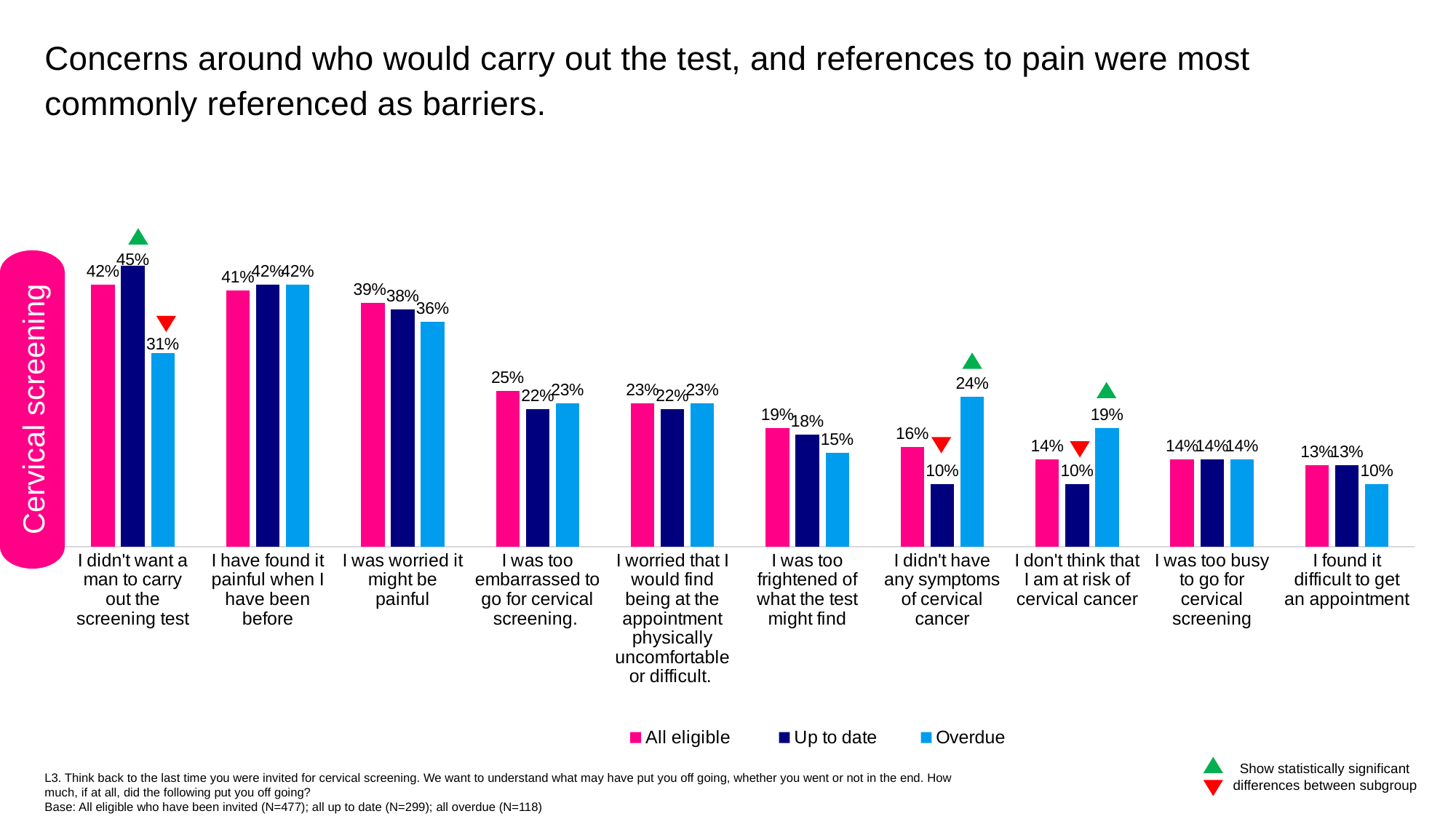
What kind of chart is shown on the slide? Bar chart Which series is shown in pink in the legend? All eligible How many series does the legend list? 3 Which category has the lowest All eligible value? I found it difficult to get an appointment What is the Up to date value for "I didn't have any symptoms of cervical cancer"? 10% Which category has the highest Up to date value? I didn't want a man to carry out the screening test What is the difference between the Overdue and Up to date values for "I didn't have any symptoms of cervical cancer"? 14% What is the All eligible value for "I was too embarrassed to go for cervical screening"? 25% What is the Overdue value for "I don't think that I am at risk of cervical cancer"? 19% What is the Overdue value for "I didn't want a man to carry out the screening test"? 31% For "I was too frightened of what the test might find", which is larger: the All eligible value or the Overdue value? All eligible How many categories (barriers) are shown on the x axis? 10